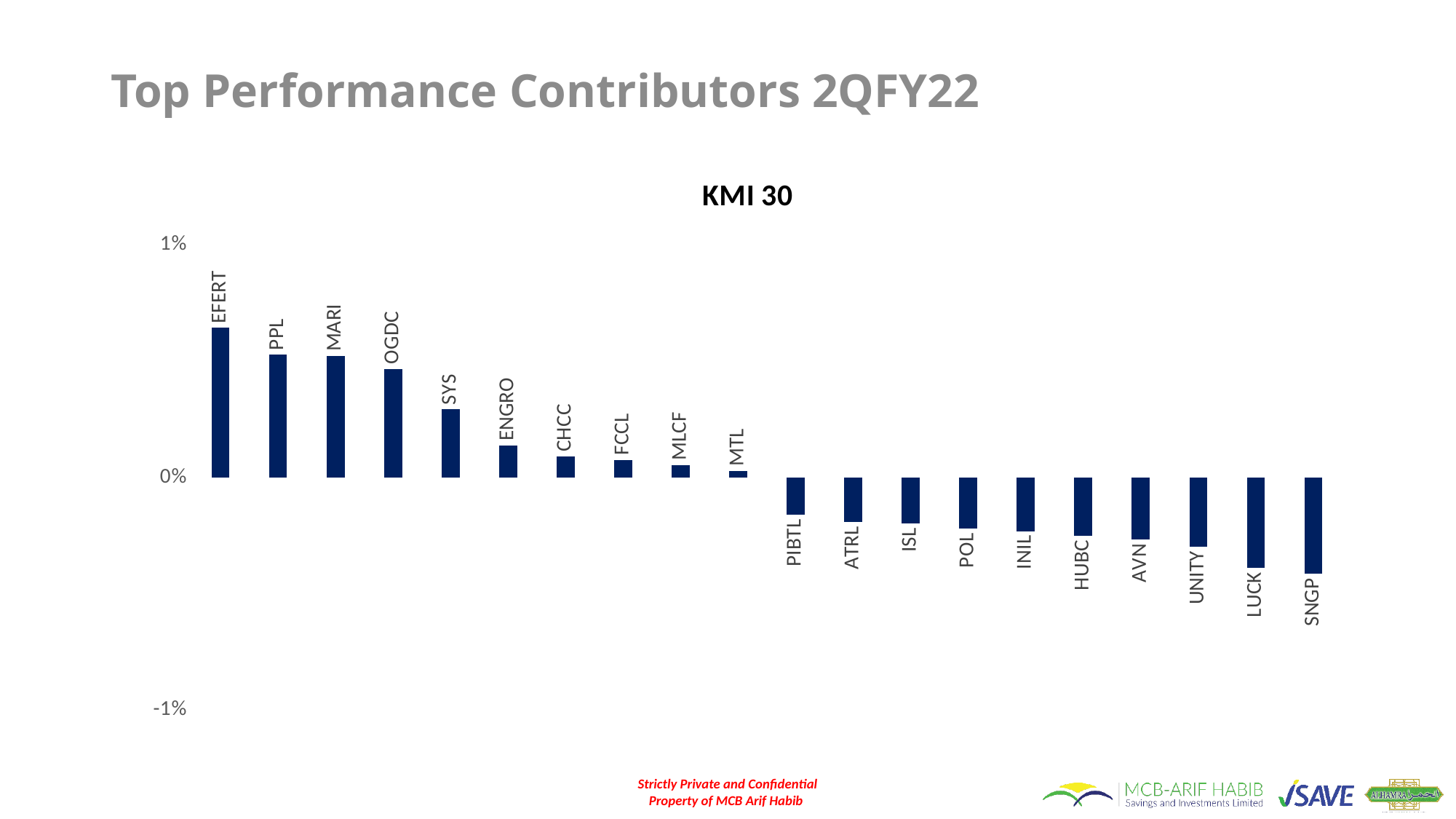
Is the value for EFERT greater or less than 0%? greater Is the value for SNGP greater or less than 0%? less Which is larger, the value for EFERT or the value for MTL? EFERT Which is larger, the value for OGDC or the value for CHCC? OGDC Is the value for PIBTL greater or less than 0%? less What kind of chart is shown on the slide? Bar chart Which category has the highest value in the KMI 30 chart? EFERT What is the lowest value shown on the vertical axis? -1% What is the title of the chart? KMI 30 Do the values rise or fall moving from left to right along the x axis? fall How many categories are plotted in the KMI 30 chart? 20